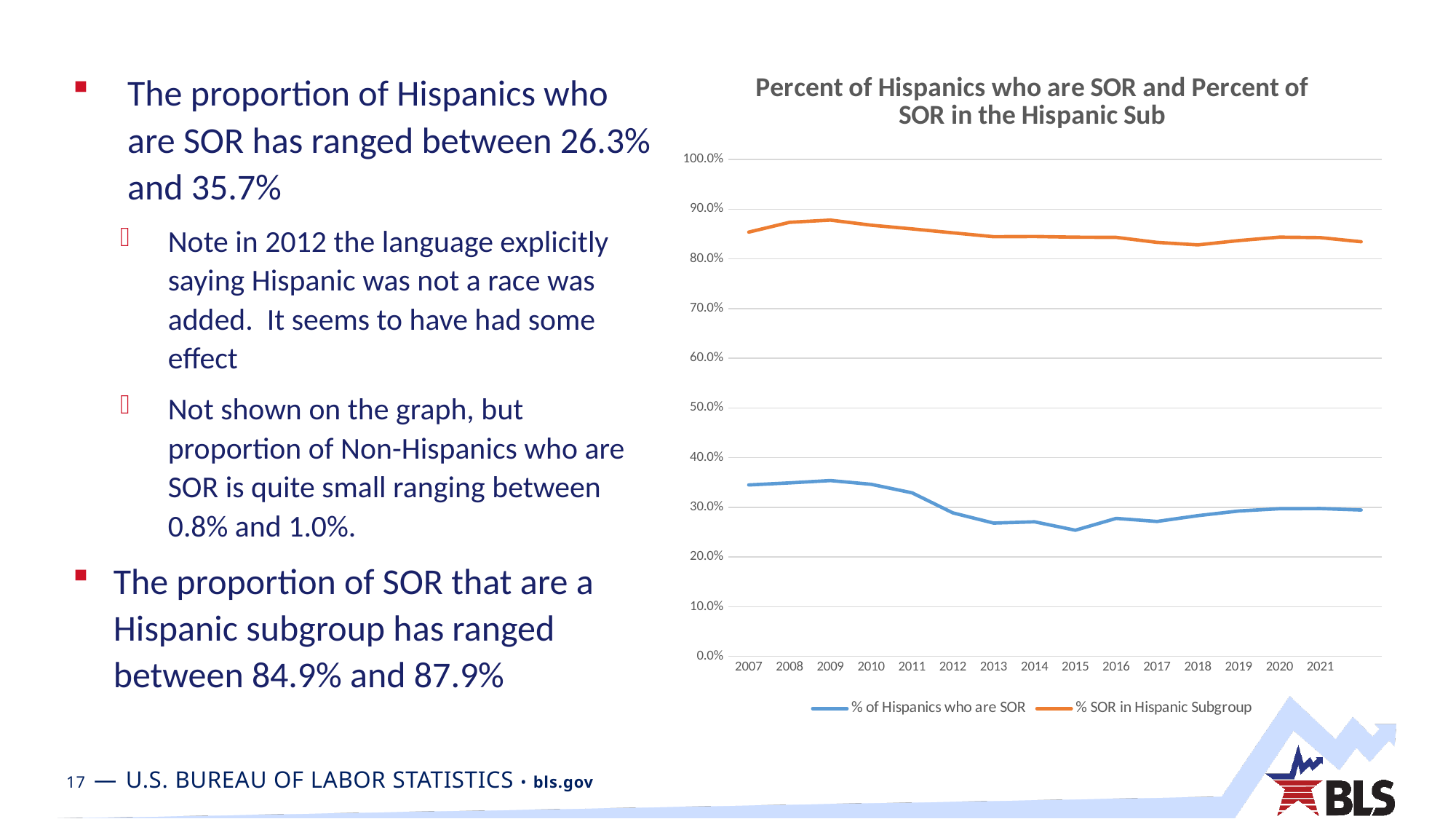
How many years are plotted along the x axis of the chart? 15 Is the value for '% SOR in Hispanic Subgroup' in 2018 greater or less than 80.0%? greater What kind of chart is shown on the slide? Line chart Is the value for '% of Hispanics who are SOR' in 2015 greater or less than 30.0%? less Which is larger for '% of Hispanics who are SOR': the value in 2007 or the value in 2015? 2007 Does the '% of Hispanics who are SOR' series rise or fall between 2007 and 2015? Fall Is the value for '% of Hispanics who are SOR' in 2007 greater or less than 30.0%? greater How many series does the chart's legend list? 2 In which year is the '% of Hispanics who are SOR' series at its lowest? 2015 Which series is drawn in orange in the chart? % SOR in Hispanic Subgroup What is the title of the chart? Percent of Hispanics who are SOR and Percent of SOR in the Hispanic Sub